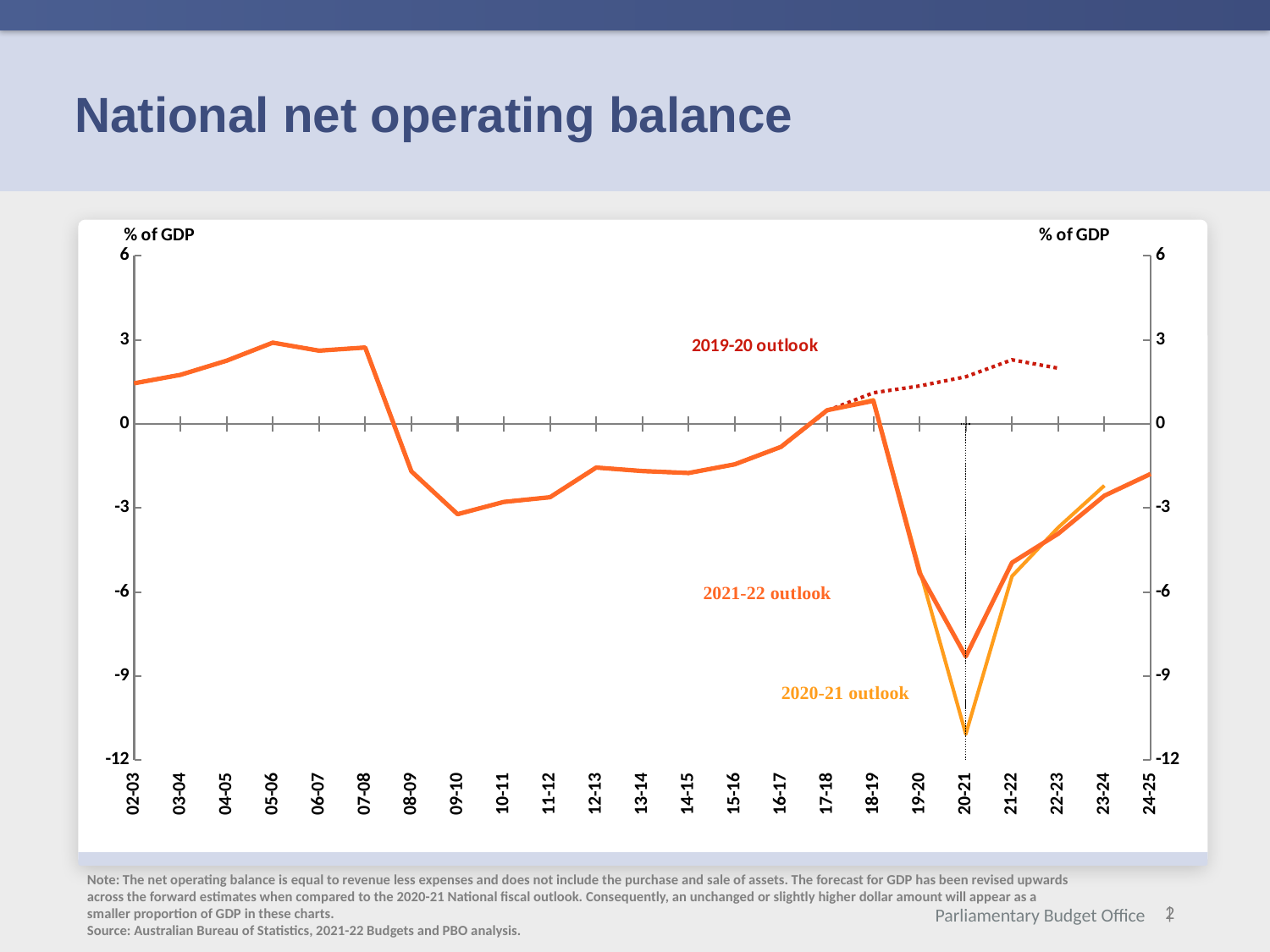
How many financial years are shown on the x axis? 23 For 20-21, which outlook shows the lower value, the 2020-21 outlook or the 2021-22 outlook? 2020-21 outlook Is the value of the 2021-22 outlook for 05-06 greater or less than 0? greater How many outlook series are labelled on the chart? 3 In which year does the 2021-22 outlook line reach its lowest value? 20-21 Is the value of the 2019-20 outlook for 22-23 greater or less than 0? greater What is the title of the slide? National net operating balance Does the 2021-22 outlook line rise or fall from 20-21 to 24-25? rise Is the value of the 2020-21 outlook for 20-21 greater or less than -9? less What kind of chart is shown on the slide? line chart What unit is shown on the vertical axis label? % of GDP